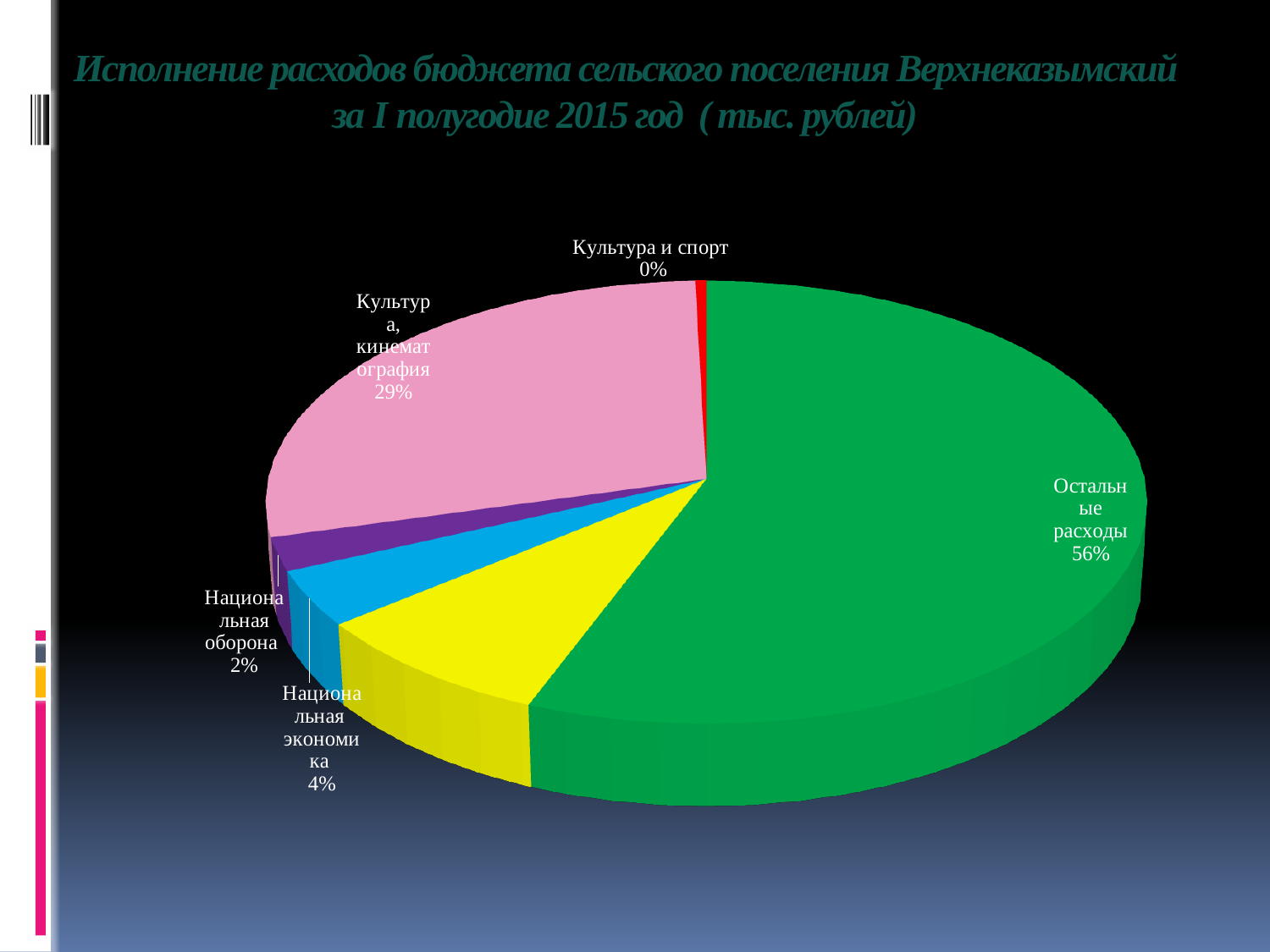
What percentage is shown for "Культура, кинематография"? 29% By how many percentage points does "Остальные расходы" exceed "Культура, кинематография"? 27 What share of the pie does "Остальные расходы" take? 56% What kind of chart is shown on the slide? pie chart What percentage is shown for "Культура и спорт"? 0% Which is larger: the share for "Национальная экономика" or for "Национальная оборона"? Национальная экономика What percentage is shown for "Национальная оборона"? 2% What percentage is shown for "Национальная экономика"? 4% Which labeled category has the largest share of the pie? Остальные расходы Which labeled category has the smallest share of the pie? Культура и спорт What is the title of the chart on the slide? Исполнение расходов бюджета сельского поселения Верхнеказымский за I полугодие 2015 год (тыс. рублей) What colour is the slice for "Остальные расходы"? green